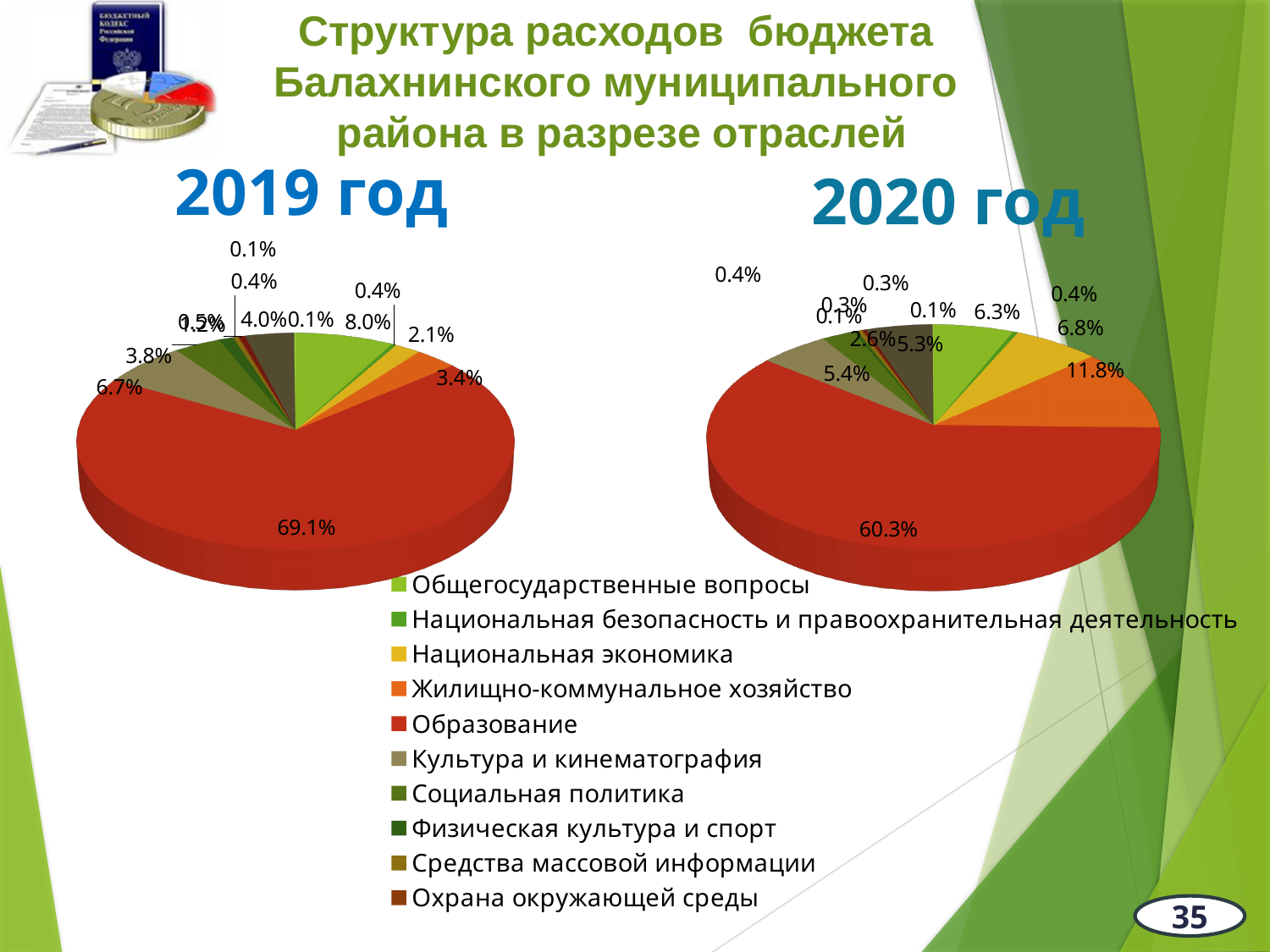
In the 2020 год pie chart, what share is labelled for Жилищно-коммунальное хозяйство? 11.8% In the 2019 год pie chart, which category has the largest share? Образование By how many percentage points does the Образование share in the 2019 год chart exceed the Образование share in the 2020 год chart? 8.8 In the 2020 год pie chart, which category has the largest share? Образование Is the share of Жилищно-коммунальное хозяйство larger in the 2019 год chart or the 2020 год chart? 2020 год In the 2020 год pie chart, what share is labelled for Образование? 60.3% In the 2019 год pie chart, what share is labelled for Общегосударственные вопросы? 8.0% How many categories does the shared legend list? 10 In the 2020 год pie chart, what share is labelled for Культура и кинематография? 5.4% What kind of chart is used for the 2019 год data? pie chart What is the title of the slide containing the two pie charts? Структура расходов бюджета Балахнинского муниципального района в разрезе отраслей In the 2019 год pie chart, what share is labelled for the largest slice (Образование)? 69.1%